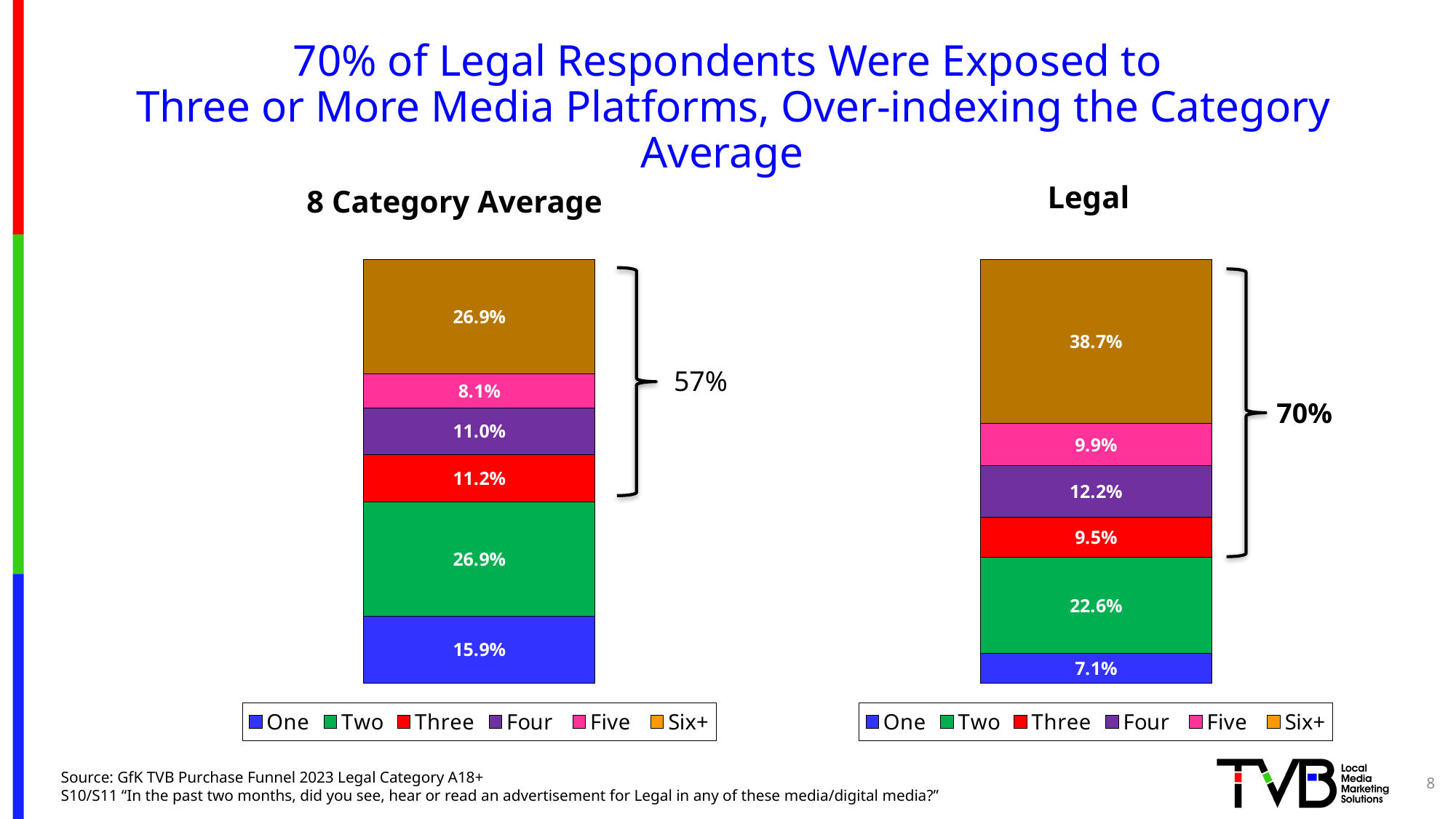
What kind of chart is the 8 Category Average chart? Stacked bar chart In the Legal chart, what is the value for the Six+ segment? 38.7% In the Legal chart, which segment has the largest value? Six+ In the 8 Category Average chart, what is the value for the Five segment? 8.1% What is the difference between the Six+ value in the Legal chart and the Six+ value in the 8 Category Average chart? 11.8 percentage points Which is larger: the Four segment in the Legal chart or the Four segment in the 8 Category Average chart? Legal What percentage does the bracket next to the Legal chart show for three or more platforms? 70% In the Legal chart, what is the value for the One segment? 7.1% How many series does the legend of the Legal chart list? 6 In the 8 Category Average chart, what is the value for the Two segment? 26.9% In the Legal chart, which segment has the smallest value? One In the 8 Category Average chart, which segment has the smallest value? Five